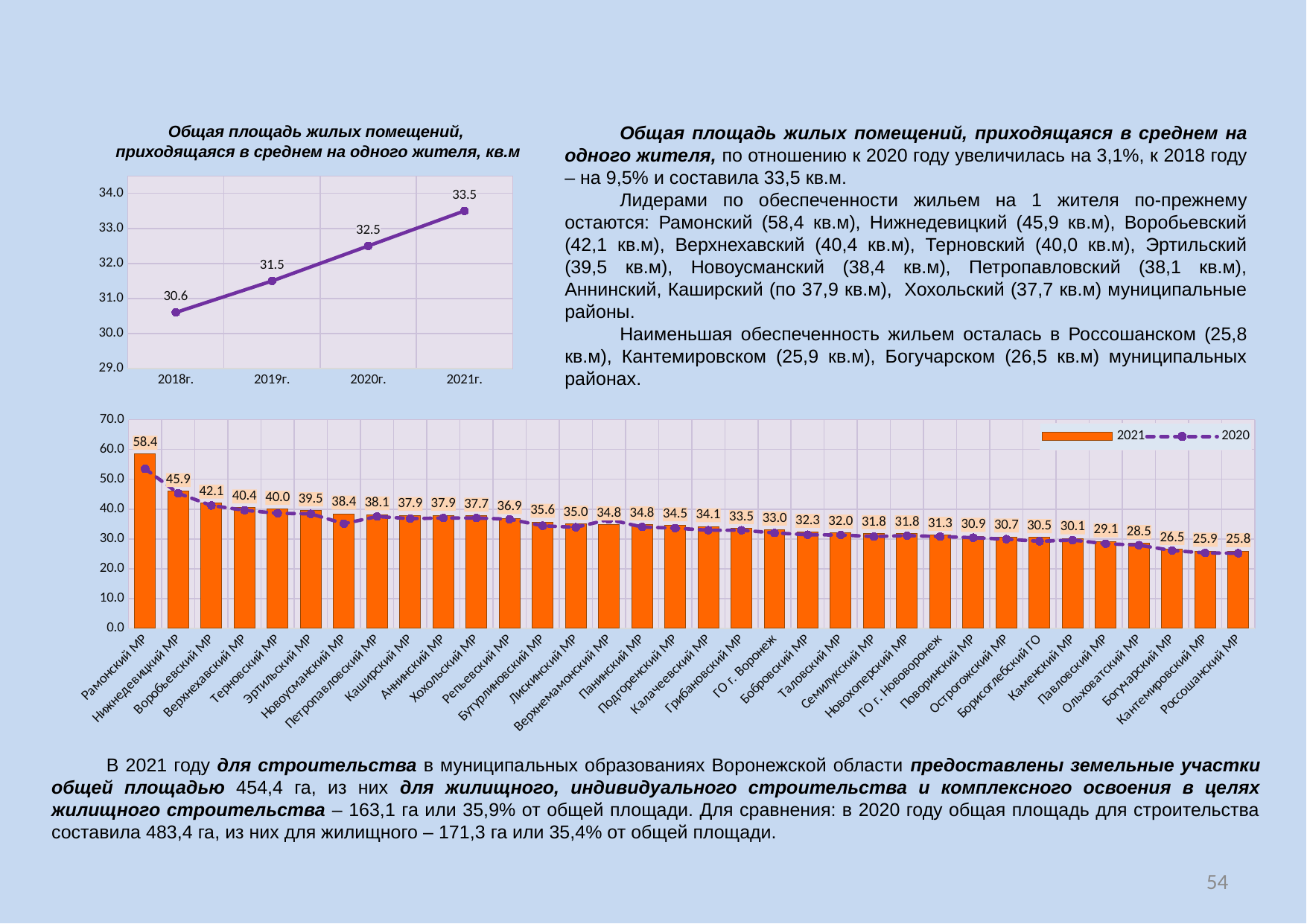
In the top-left chart, what kind of chart is used? line chart In the top-left chart, what is the value for 2018г.? 30.6 In the top-left chart 'Общая площадь жилых помещений, приходящаяся в среднем на одного жителя, кв.м', what is the value for 2021г.? 33.5 In the bottom chart, how many series does the legend list? 2 In the bottom chart, what is the difference between the 2021 values for Рамонский МР and Нижнедевицкий МР? 12.5 In the bottom chart, which district has the highest 2021 value? Рамонский МР In the top-left chart, what is the difference between the 2021г. and 2018г. values? 2.9 In the top-left chart, do the values rise or fall from 2018г. to 2021г.? rise In the top-left chart, how many data points are plotted? 4 In the bottom chart, which district has the lowest 2021 value? Россошанский МР In the bottom chart, what is the 2021 value for Воробьевский МР? 42.1 In the bottom chart, which is larger: the 2021 value for Терновский МР or for Эртильский МР? Терновский МР